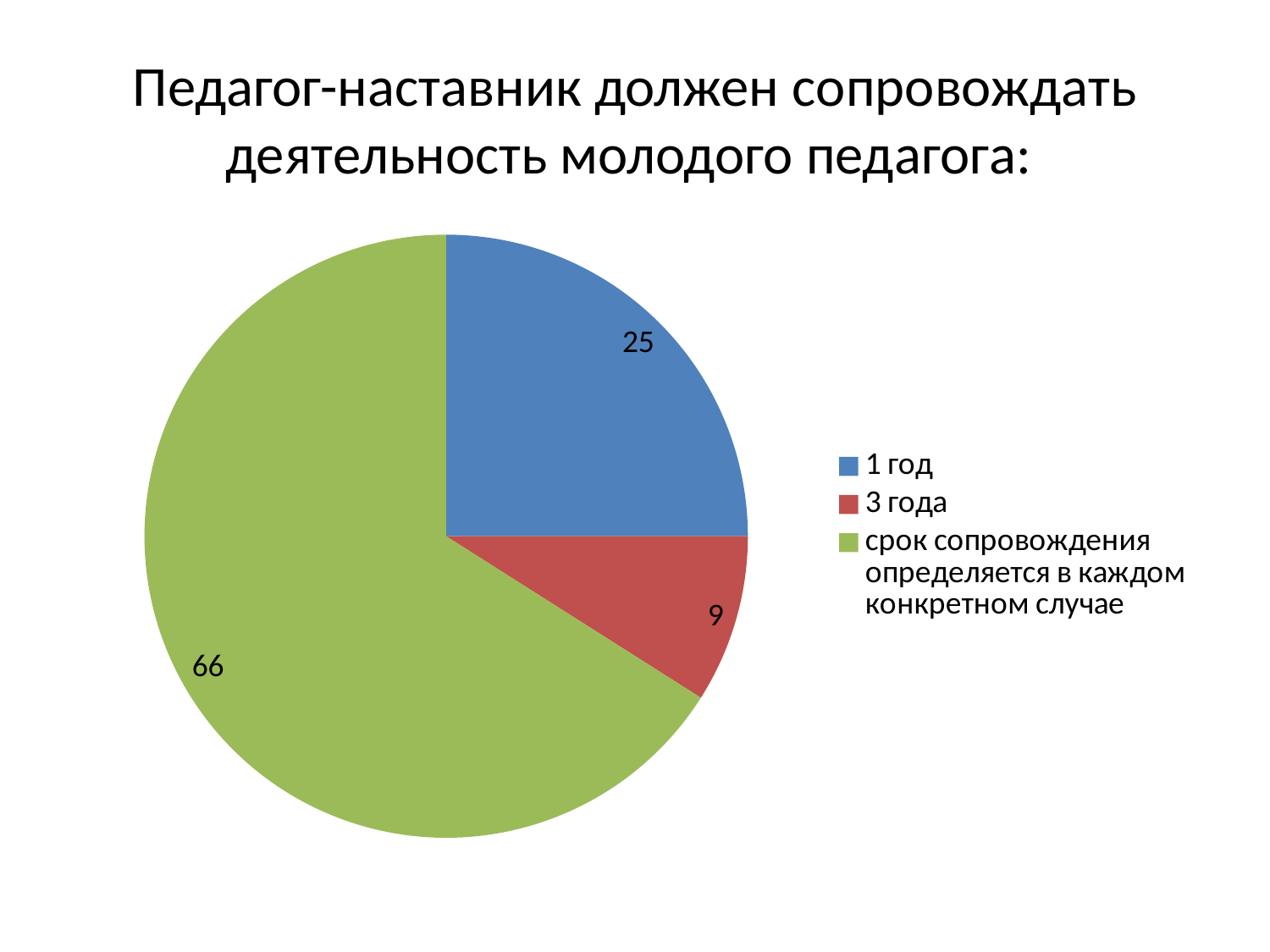
Which category has the smallest slice? 3 года What is the total of all the slices in the pie chart? 100 Which is larger, the value for "1 год" or the value for "3 года"? 1 год What share of the pie does the "1 год" slice represent? 25% What is the value for "3 года"? 9 What colour is the slice for "3 года"? red What is the value for "срок сопровождения определяется в каждом конкретном случае"? 66 What kind of chart is shown on the slide? pie chart Which category has the largest slice? срок сопровождения определяется в каждом конкретном случае How many slices does the pie chart have? 3 What is the value for "1 год"? 25 What is the difference between the values for "1 год" and "3 года"? 16